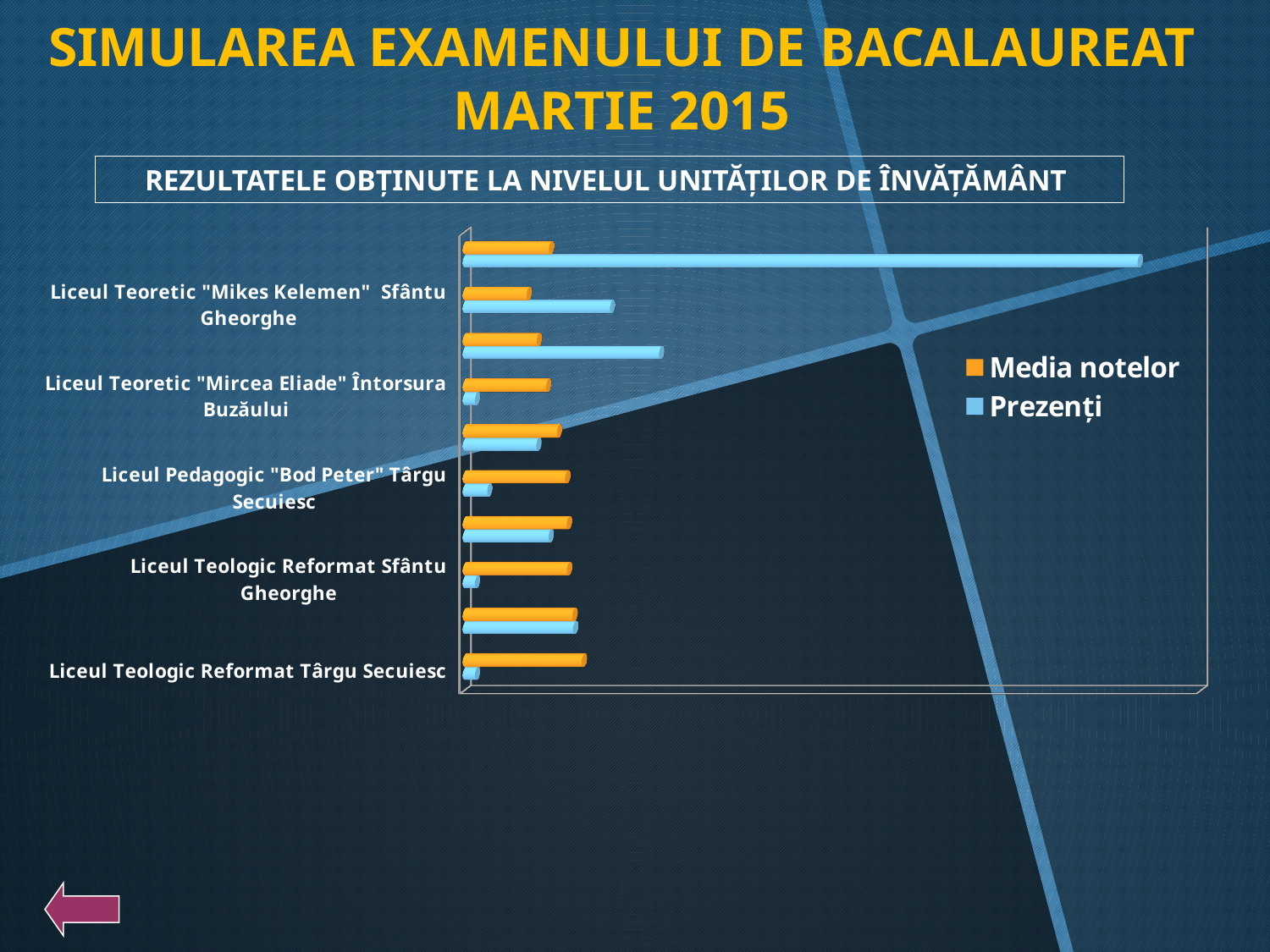
Which colour represents the "Prezenți" series in the chart? Blue For the topmost category in the chart, which series has the longer bar, Media notelor or Prezenți? Prezenți What kind of chart is shown on the slide? Bar chart Are the bars in the chart drawn horizontally or vertically? Horizontally How many series does the chart legend list? 2 Which series has the single longest bar in the chart? Prezenți For the bottom category in the chart, which series has the longer bar, Media notelor or Prezenți? Media notelor What are the two series named in the chart legend? Media notelor and Prezenți How many categories (pairs of bars) are plotted in the chart? 10